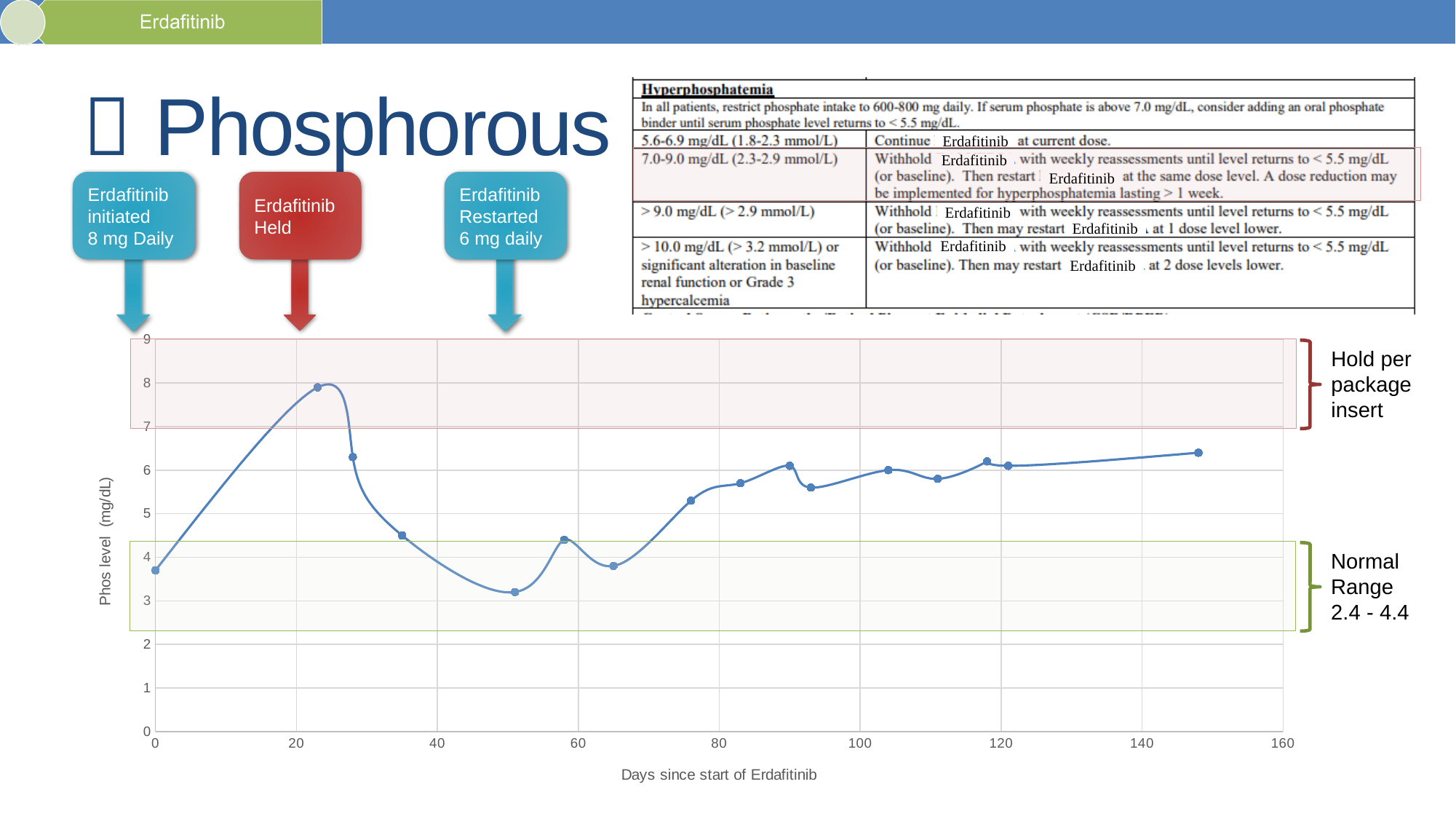
What is the label of the x axis of the chart? Days since start of Erdafitinib Is the highest phosphorus level on the chart greater or less than 7? greater What kind of chart is shown on the slide? line chart Between day 0 and the peak around day 23, does the phosphorus level rise or fall? rise What is the label of the y axis of the chart? Phos level (mg/dL) Is the lowest phosphorus level on the chart greater or less than 4? less Does the lowest phosphorus level occur before or after day 80? before Does the peak phosphorus level occur before or after day 40? before Which is larger, the phosphorus level at the peak around day 23 or the level at the last point around day 148? the peak around day 23 Is the phosphorus level at day 0 greater or less than 5? less How many data points are plotted on the line? 16